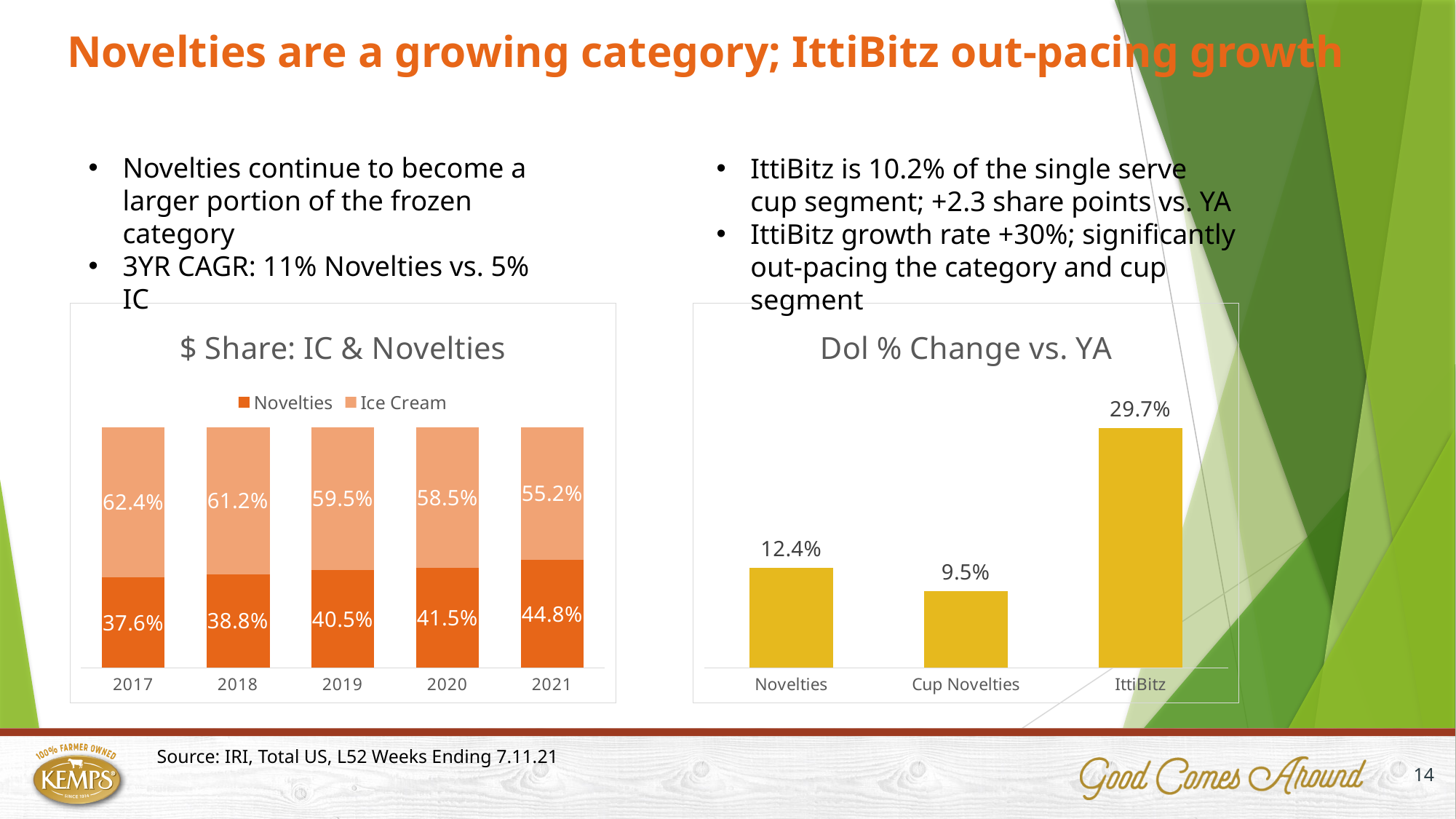
In the '$ Share: IC & Novelties' chart, how many series does the legend list? 2 In the 'Dol % Change vs. YA' chart, which category has the highest value? IttiBitz In the '$ Share: IC & Novelties' chart, which year has the lowest Ice Cream share? 2021 In the 'Dol % Change vs. YA' chart, what is the difference between IttiBitz and Novelties? 17.3% In the '$ Share: IC & Novelties' chart, what is the Novelties share in 2021? 44.8% In the '$ Share: IC & Novelties' chart, does the Novelties share rise or fall from 2017 to 2021? rise In the '$ Share: IC & Novelties' chart, what is the Ice Cream share in 2017? 62.4% In the 'Dol % Change vs. YA' chart, what is the value for Cup Novelties? 9.5% What kind of chart is the 'Dol % Change vs. YA' chart? bar chart In the '$ Share: IC & Novelties' chart, which year has the highest Novelties share? 2021 In the 'Dol % Change vs. YA' chart, how many categories are shown? 3 In the '$ Share: IC & Novelties' chart, what is the difference between the Ice Cream share and the Novelties share in 2019? 19.0%